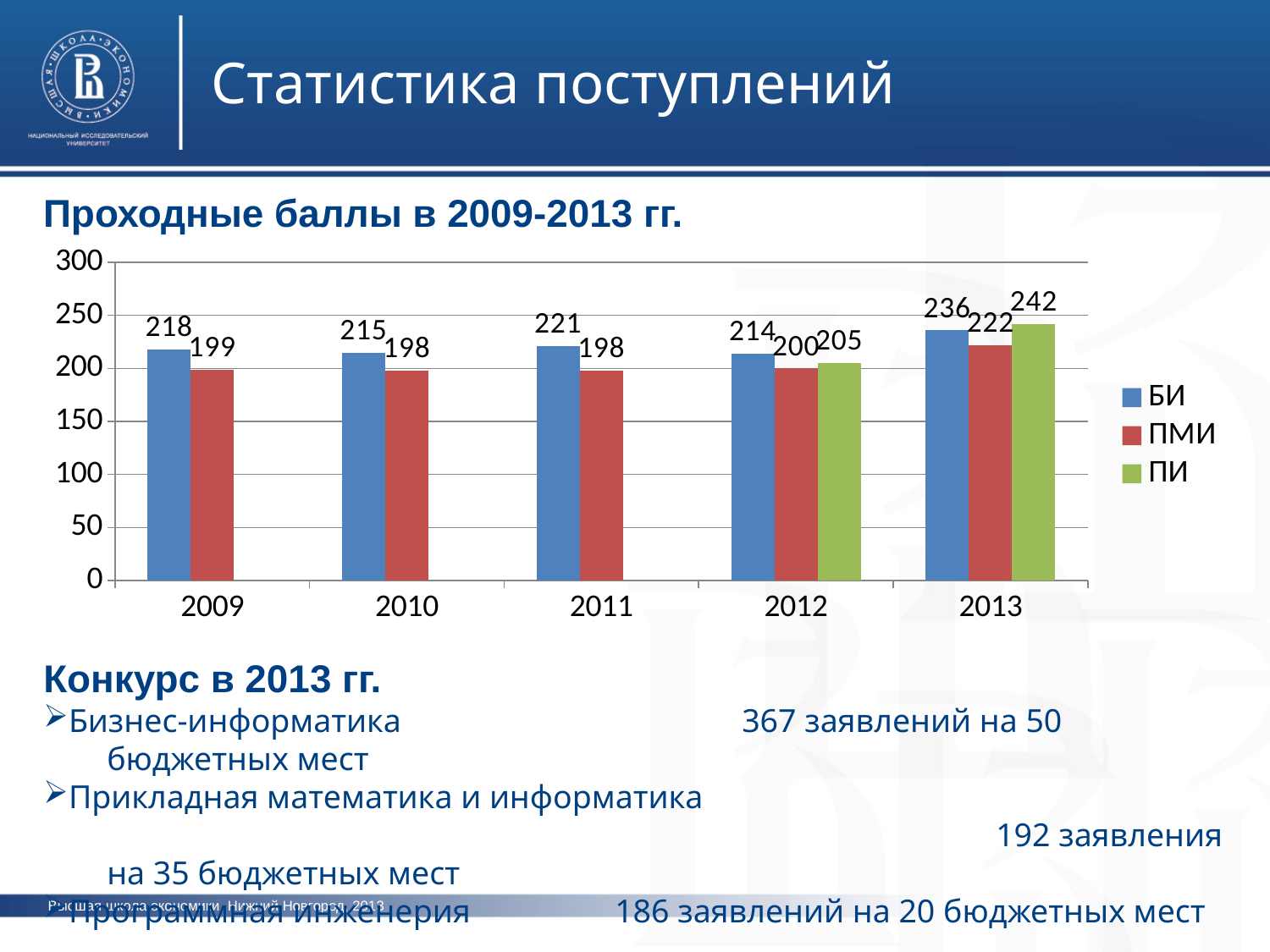
What is the difference between the БИ and ПМИ values in 2013? 14 What is the value for ПИ in 2013? 242 What is the value for БИ in 2009? 218 How many years are shown on the x axis? 5 How many series does the legend list? 3 What is the title of the chart? Проходные баллы в 2009-2013 гг. What kind of chart is shown on the slide? bar chart What is the value for ПМИ in 2011? 198 Does the value for ПМИ rise or fall from 2012 to 2013? rise Which year has the highest value for БИ? 2013 Which is larger in 2012: the value for ПИ or the value for ПМИ? ПИ